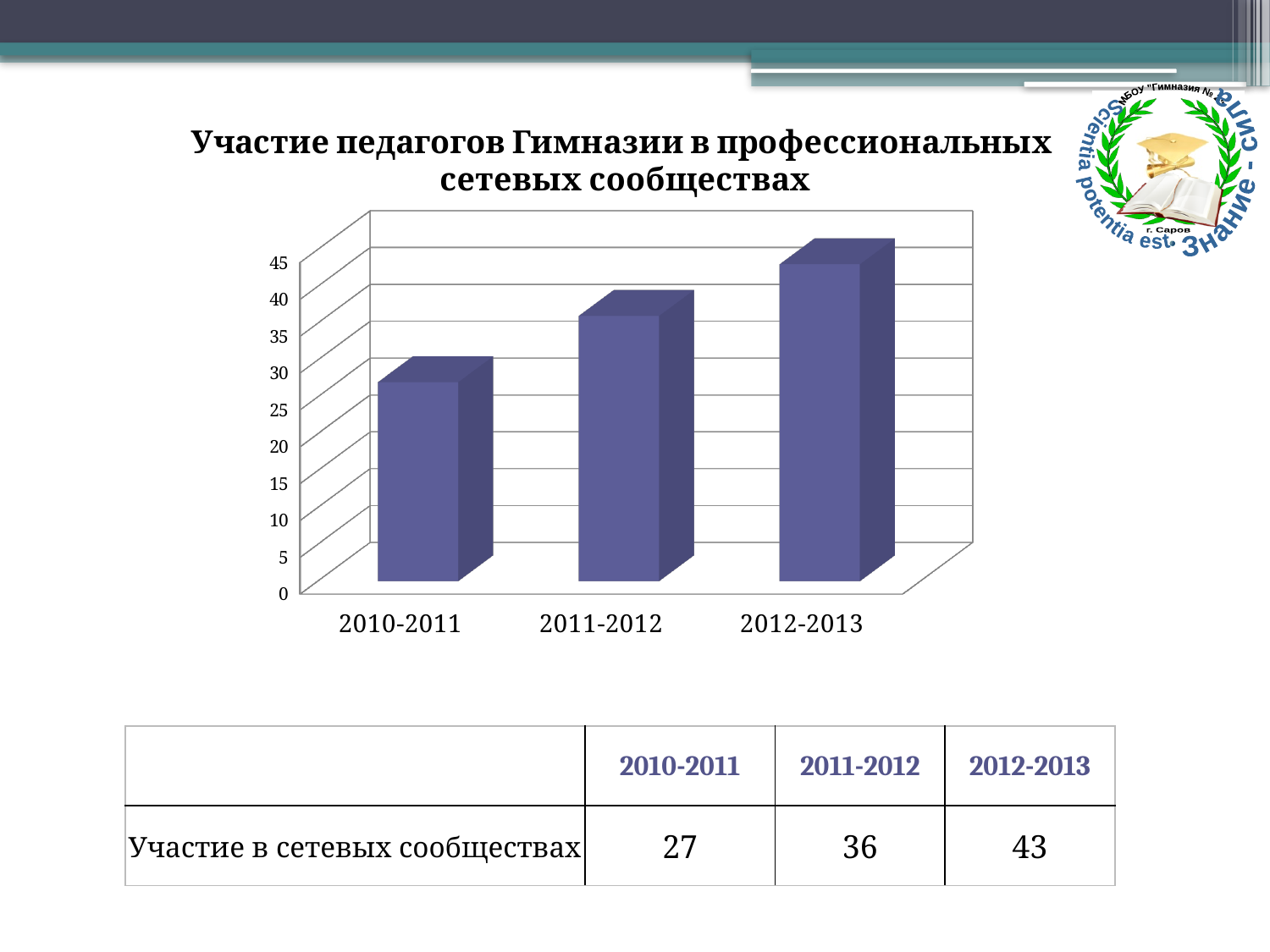
Is the value for 2011-2012 greater or less than 30? greater What is the value for 2010-2011? 27 What is the difference between the values for 2011-2012 and 2010-2011? 9 What is the value for 2011-2012? 36 Which period has the highest value? 2012-2013 What kind of chart is shown on the slide? bar chart How many periods are shown on the x axis? 3 Which is larger, the value for 2011-2012 or the value for 2012-2013? 2012-2013 Do the values rise or fall from 2010-2011 to 2012-2013? rise What is the value for 2012-2013? 43 Which period has the lowest value? 2010-2011 What is the difference between the values for 2012-2013 and 2010-2011? 16